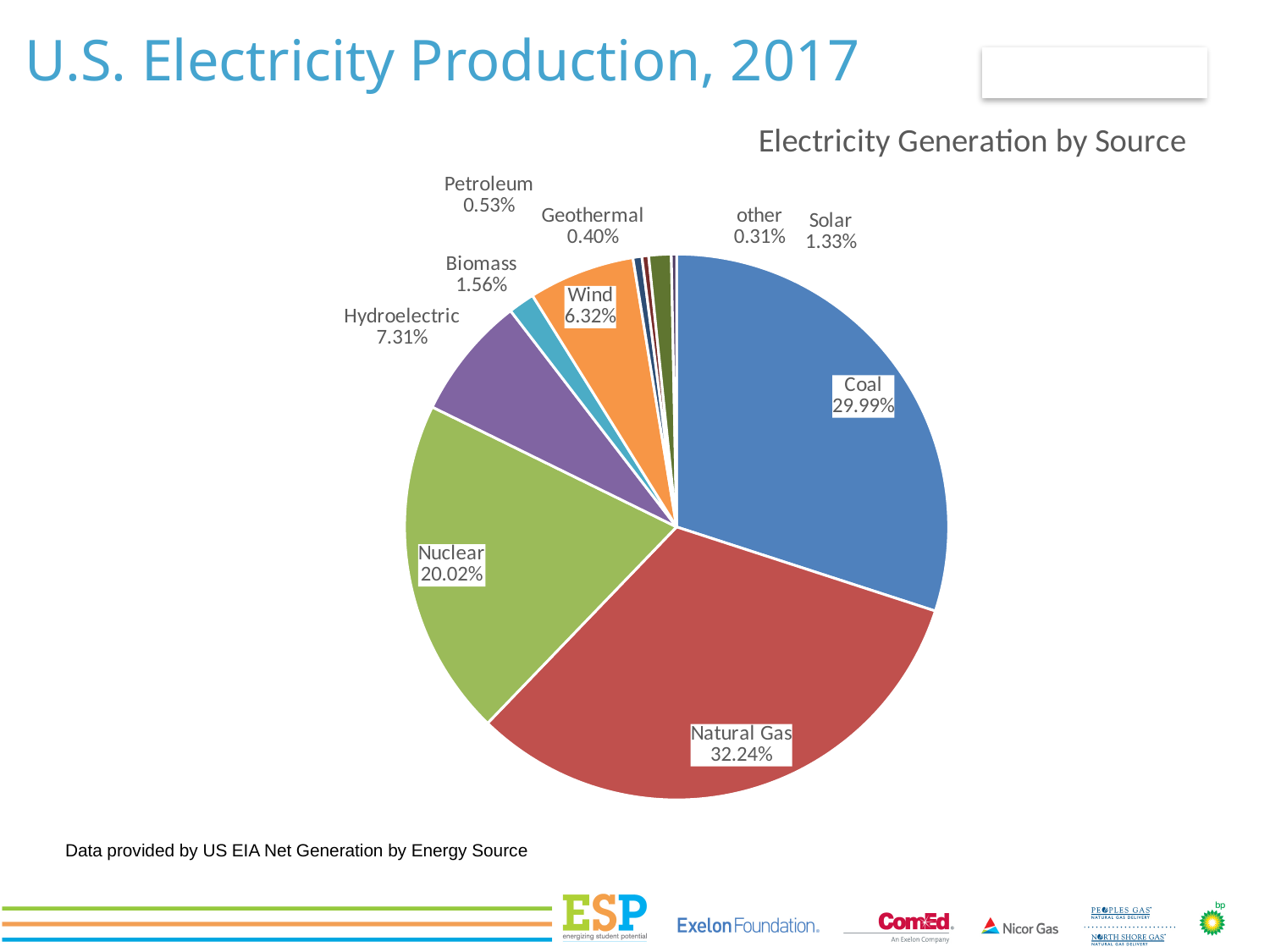
What share of electricity generation does Natural Gas account for? 32.24% What share of electricity generation does Wind account for? 6.32% What share of electricity generation does Hydroelectric account for? 7.31% What share of electricity generation does Coal account for? 29.99% What is the title of the chart? Electricity Generation by Source Which has a larger share, Hydroelectric or Wind? Hydroelectric What kind of chart is shown on the slide? Pie chart Which source has the largest share of electricity generation? Natural Gas How many sources (slices) are shown in the pie chart? 10 Which source has the smallest share of electricity generation? other What is the difference between the Natural Gas share and the Coal share? 2.25% What share of electricity generation does Nuclear account for? 20.02%